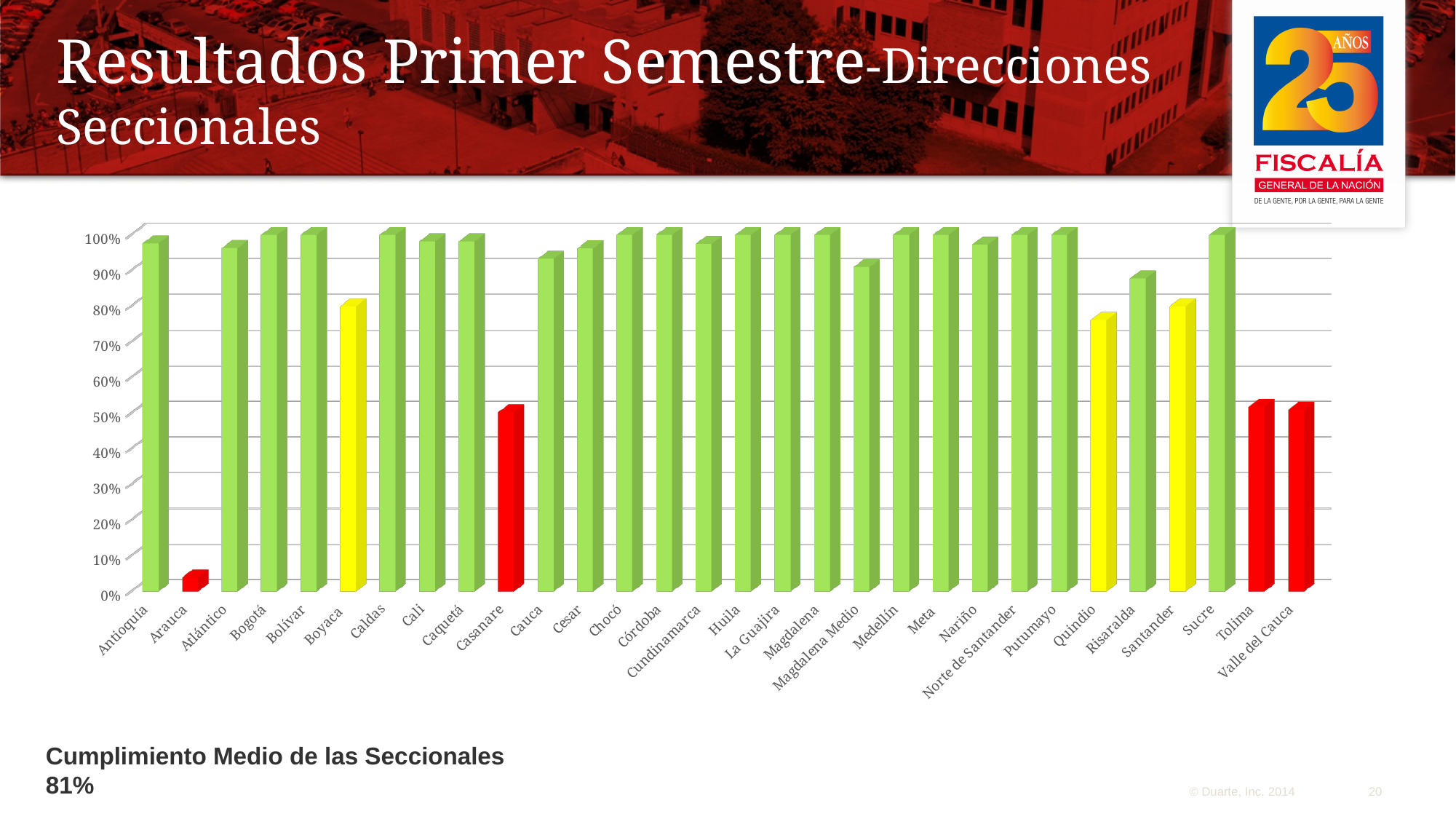
Which seccional has the lowest value in the chart? Arauca Which has the larger value, Casanare or Cauca? Cauca How many seccionales (categories) are plotted on the x axis of the chart? 30 Is the value for Magdalena Medio greater or less than 80%? greater Is the value for Quindio greater or less than 80%? less Is the value for Tolima greater or less than 60%? less According to the text below the chart, what is the Cumplimiento Medio de las Seccionales? 81% How many bars in the chart are coloured red? 4 What kind of chart is shown on the slide? bar chart